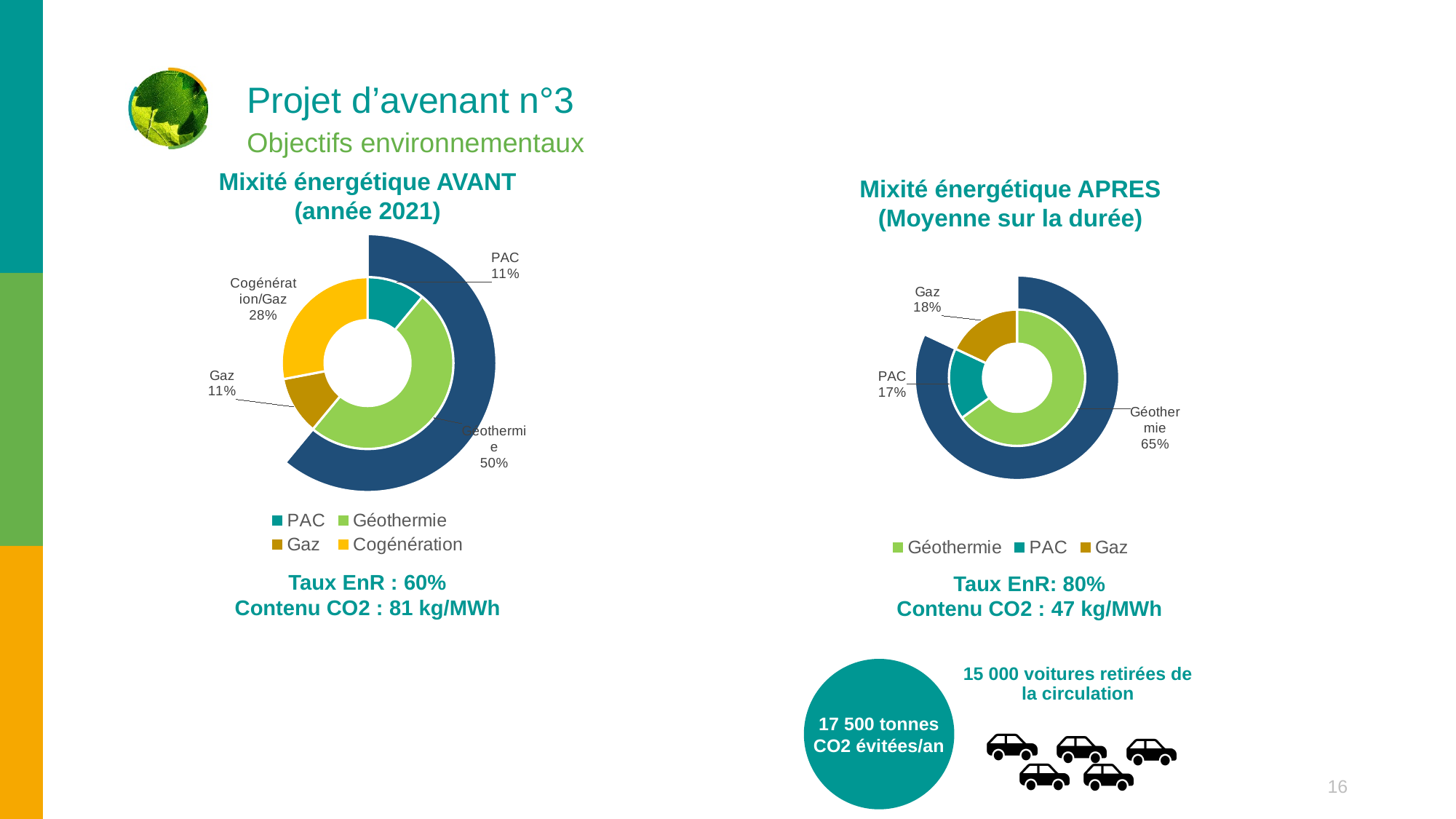
In the 'Mixité énergétique AVANT (année 2021)' chart, what colour represents Cogénération in the legend? Yellow In the 'Mixité énergétique APRES (Moyenne sur la durée)' chart, what share does Géothermie have? 65% What kind of chart is the 'Mixité énergétique APRES (Moyenne sur la durée)' chart? Doughnut (pie) chart In the 'Mixité énergétique APRES (Moyenne sur la durée)' chart, which category has the smallest share? PAC In the 'Mixité énergétique APRES (Moyenne sur la durée)' chart, how many entries does the legend list? 3 In the 'Mixité énergétique AVANT (année 2021)' chart, what is the difference between the Géothermie share and the Cogénération/Gaz share? 22 percentage points In the 'Mixité énergétique AVANT (année 2021)' chart, how many categories are shown? 4 In the 'Mixité énergétique APRES (Moyenne sur la durée)' chart, what share does PAC have? 17% In the 'Mixité énergétique AVANT (année 2021)' chart, what share does Cogénération/Gaz have? 28% In the 'Mixité énergétique AVANT (année 2021)' chart, what share does Géothermie have? 50% Is the PAC share larger in the 'Mixité énergétique AVANT' chart or in the 'Mixité énergétique APRES' chart? Mixité énergétique APRES In the 'Mixité énergétique AVANT (année 2021)' chart, which category has the largest share? Géothermie